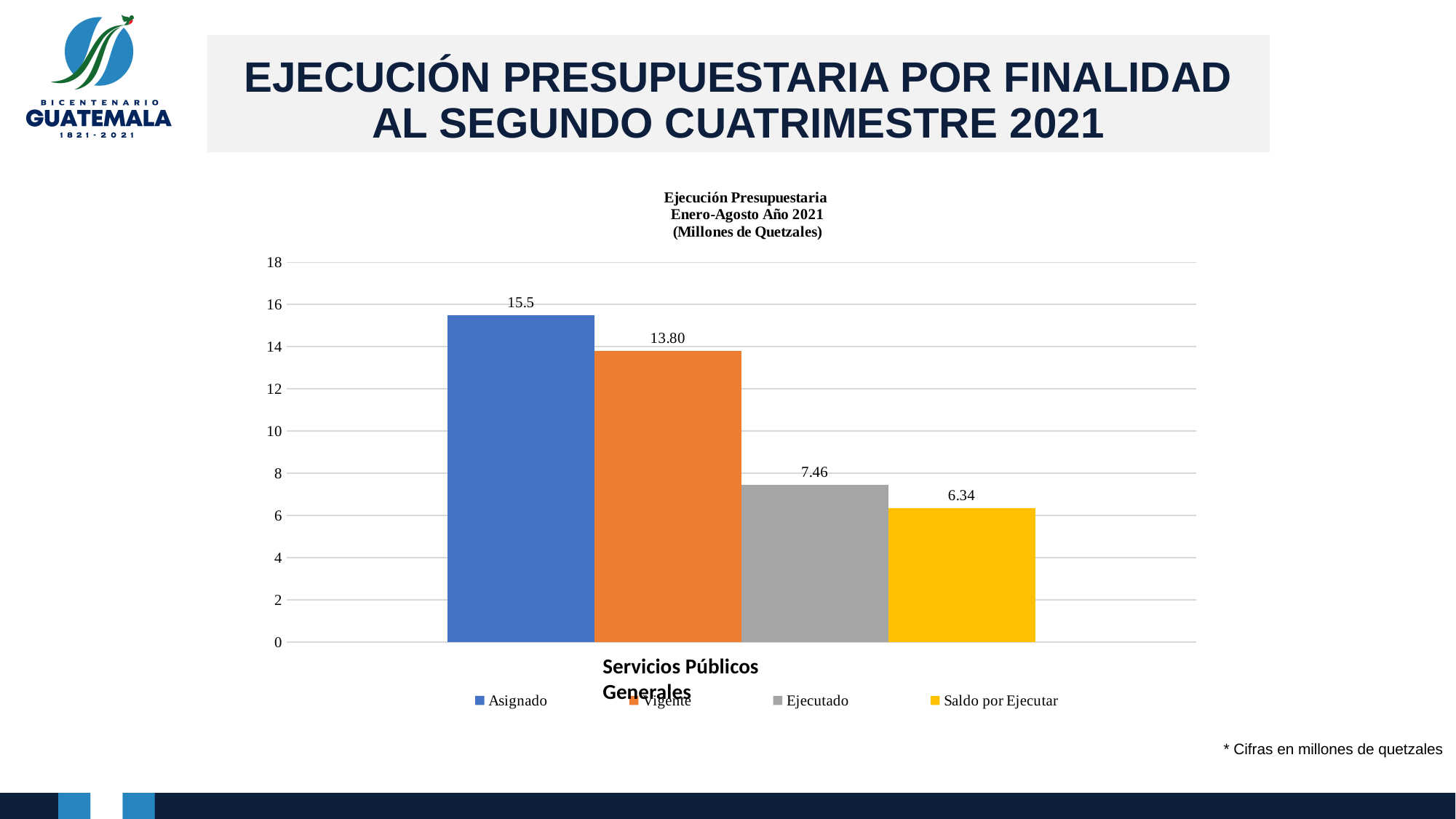
What is the category label shown on the x axis? Servicios Públicos Generales What is the value of the Asignado bar? 15.5 Which series has the lowest value? Saldo por Ejecutar How many series does the legend list? 4 What is the difference between the Vigente and Ejecutado values? 6.34 What is the value of the Ejecutado bar? 7.46 What is the value of the Vigente bar? 13.80 Which is larger, Ejecutado or Saldo por Ejecutar? Ejecutado Which series has the highest value? Asignado What kind of chart is shown on the slide? Bar chart What is the value of the Saldo por Ejecutar bar? 6.34 What is the difference between the Asignado and Vigente values? 1.7